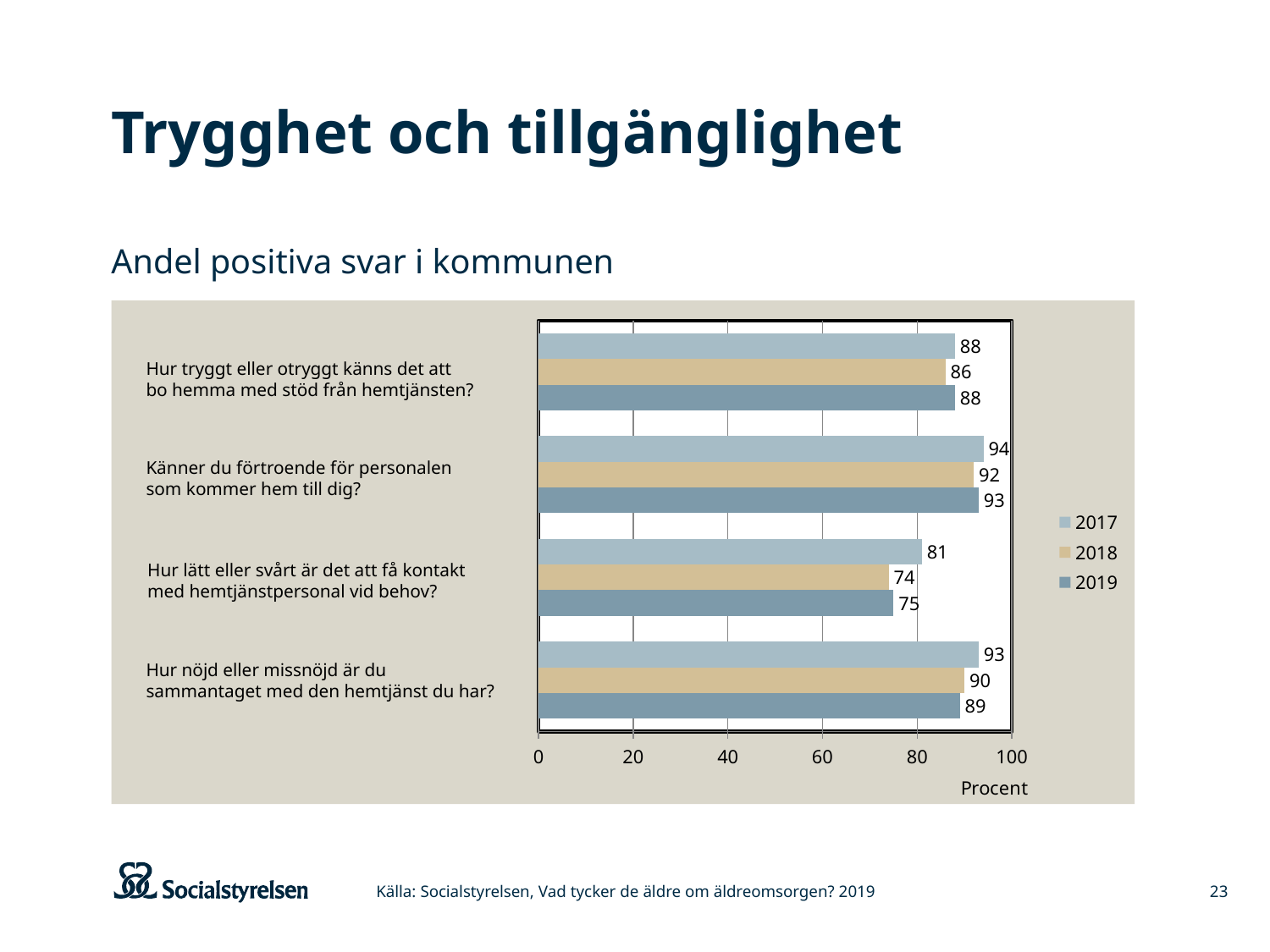
What is the 2019 value for "Hur tryggt eller otryggt känns det att bo hemma med stöd från hemtjänsten?"? 88 What kind of chart is shown on the slide? Bar chart What is the 2018 value for "Hur lätt eller svårt är det att få kontakt med hemtjänstpersonal vid behov?"? 74 Which question has the highest 2017 value? Känner du förtroende för personalen som kommer hem till dig? How many series does the legend list? 3 Which question has the lowest 2019 value? Hur lätt eller svårt är det att få kontakt med hemtjänstpersonal vid behov? Is the 2018 value for "Känner du förtroende för personalen som kommer hem till dig?" greater or less than 80? greater How many questions (categories) are shown on the chart? 4 What is the difference between the 2017 and 2018 values for "Hur lätt eller svårt är det att få kontakt med hemtjänstpersonal vid behov?"? 7 What is the label on the horizontal axis of the chart? Procent What is the 2017 value for "Hur nöjd eller missnöjd är du sammantaget med den hemtjänst du har?"? 93 For "Hur nöjd eller missnöjd är du sammantaget med den hemtjänst du har?", which year has the larger value, 2018 or 2019? 2018